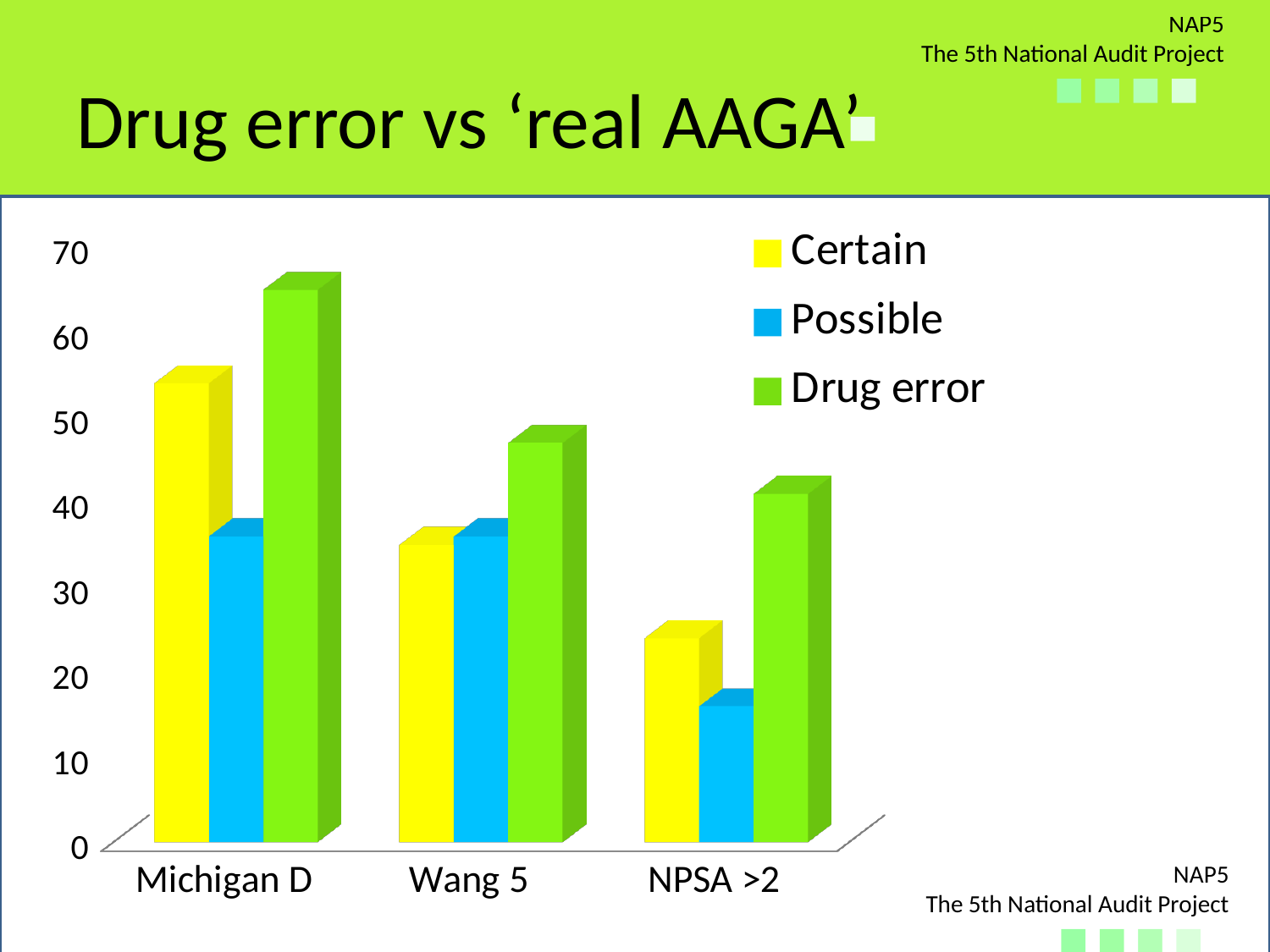
How many series does the chart's legend list? 3 Which category has the lowest Possible value? NPSA >2 What kind of chart is shown on the slide? Bar chart Is the Drug error value for Michigan D greater or less than 60? greater Which category has the lowest Certain value? NPSA >2 Which category has the highest Drug error value? Michigan D Is the Certain value for Michigan D greater or less than 50? greater How many categories are shown on the x axis of the chart? 3 Which colour represents the Drug error series in the chart? Green Is the Possible value for NPSA >2 greater or less than 20? less For Michigan D, which is larger: the Certain value or the Possible value? Certain What is the title of the slide containing the chart? Drug error vs 'real AAGA'